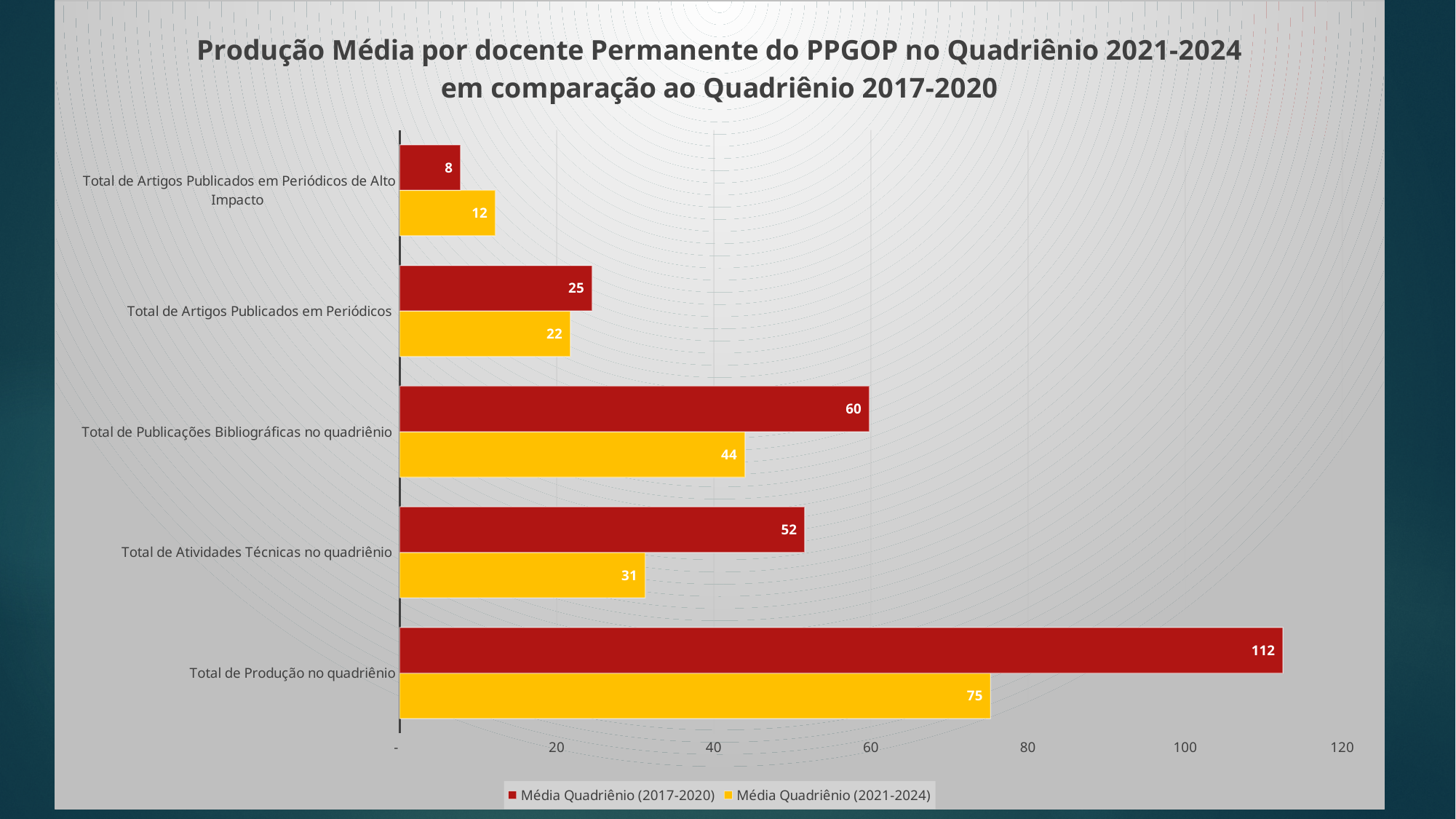
What is the value of Média Quadriênio (2017-2020) for Total de Produção no quadriênio? 112 Is the Média Quadriênio (2021-2024) value for Total de Produção no quadriênio greater or less than 80? less Which category has the lowest value for Média Quadriênio (2017-2020)? Total de Artigos Publicados em Periódicos de Alto Impacto What kind of chart is shown on the slide? bar chart For Total de Artigos Publicados em Periódicos, which series has the larger value: Média Quadriênio (2017-2020) or Média Quadriênio (2021-2024)? Média Quadriênio (2017-2020) What is the value of Média Quadriênio (2021-2024) for Total de Atividades Técnicas no quadriênio? 31 Which colour represents Média Quadriênio (2021-2024) in the chart? yellow How many series does the legend list? 2 What is the difference between the Média Quadriênio (2017-2020) and Média Quadriênio (2021-2024) values for Total de Publicações Bibliográficas no quadriênio? 16 What is the value of Média Quadriênio (2021-2024) for Total de Artigos Publicados em Periódicos de Alto Impacto? 12 How many categories are shown on the chart? 5 Which category has the highest value for Média Quadriênio (2021-2024)? Total de Produção no quadriênio